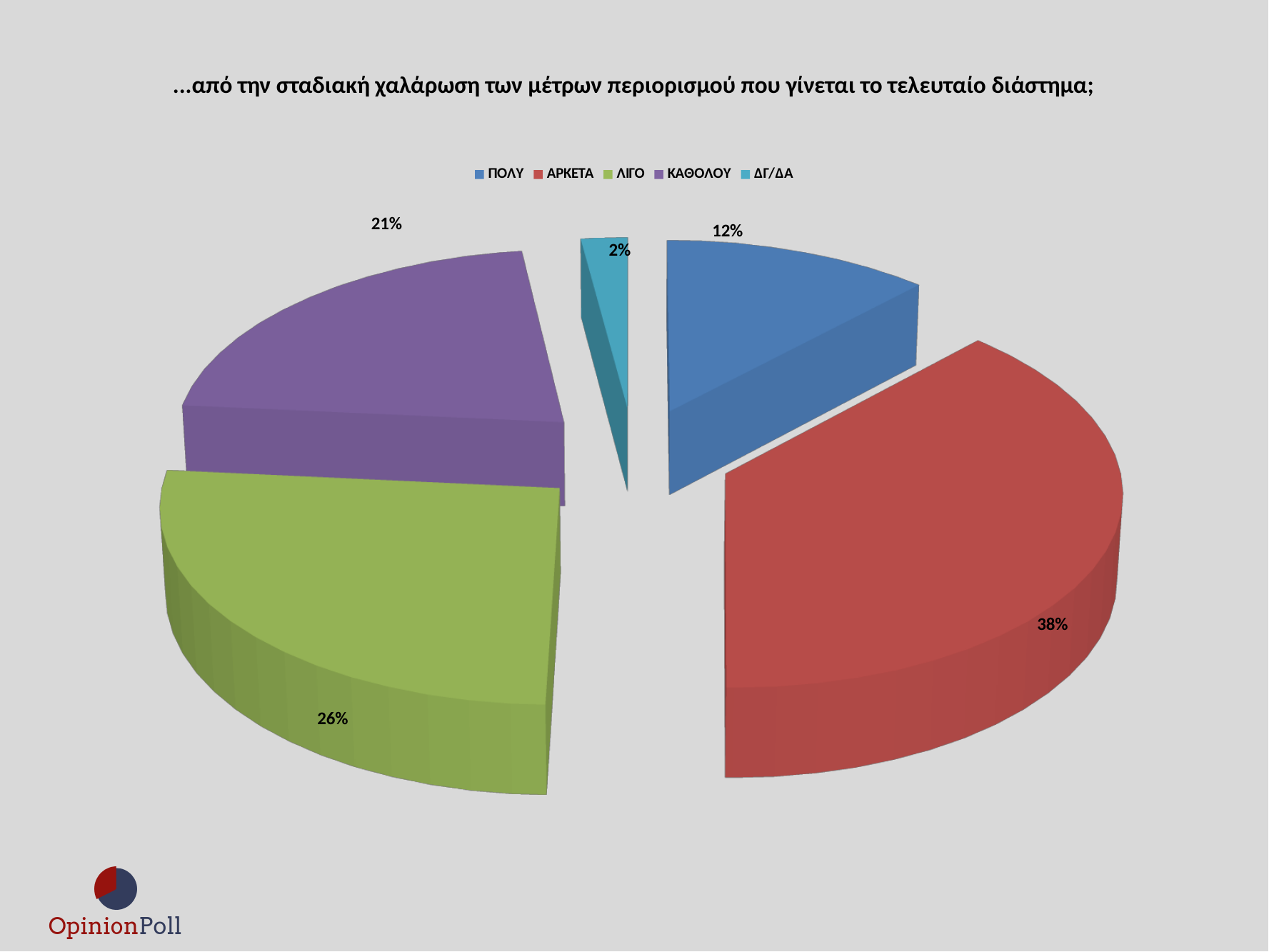
What kind of chart is shown on the slide? Pie chart What percentage of the pie is ΔΓ/ΔΑ? 2% What is the difference in percentage points between ΑΡΚΕΤΑ and ΛΙΓΟ? 12 What percentage of the pie is ΛΙΓΟ? 26% Which category has the smallest slice of the pie? ΔΓ/ΔΑ What percentage of the pie is ΑΡΚΕΤΑ? 38% Which category has the largest slice of the pie? ΑΡΚΕΤΑ What colour is the slice for ΚΑΘΟΛΟΥ? Purple What percentage of the pie is ΠΟΛΥ? 12% How many slices does the pie chart have? 5 Which is larger, the slice for ΛΙΓΟ or the slice for ΚΑΘΟΛΟΥ? ΛΙΓΟ What percentage of the pie is ΚΑΘΟΛΟΥ? 21%